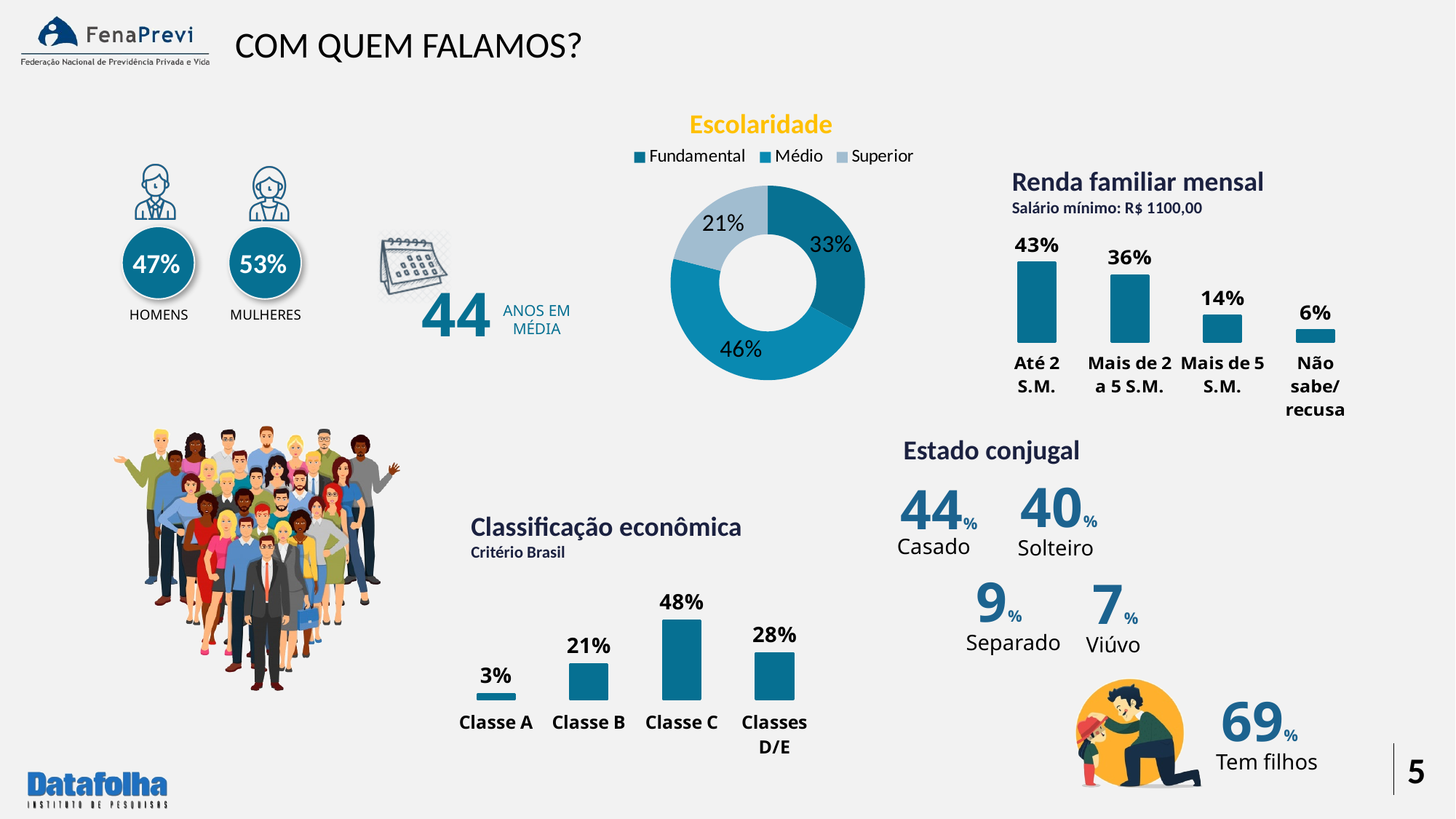
In the Escolaridade chart, what share of respondents have Médio education? 46% What kind of chart is the Escolaridade chart? Donut (pie) chart In the Escolaridade chart, what share of respondents have Superior education? 21% In the Classificação econômica chart, which class has the highest value? Classe C In the Renda familiar mensal chart, what is the difference between Mais de 2 a 5 S.M. and Mais de 5 S.M.? 22 percentage points In the Escolaridade chart, which education level has the largest share? Médio How many categories does the Renda familiar mensal chart show? 4 In the Renda familiar mensal chart, what is the value for Até 2 S.M.? 43% How many entries does the legend of the Escolaridade chart list? 3 In the Classificação econômica chart, what is the value for Classe B? 21% In the Classificação econômica chart, which is larger, Classe B or Classes D/E? Classes D/E In the Renda familiar mensal chart, which category has the lowest value? Não sabe/recusa